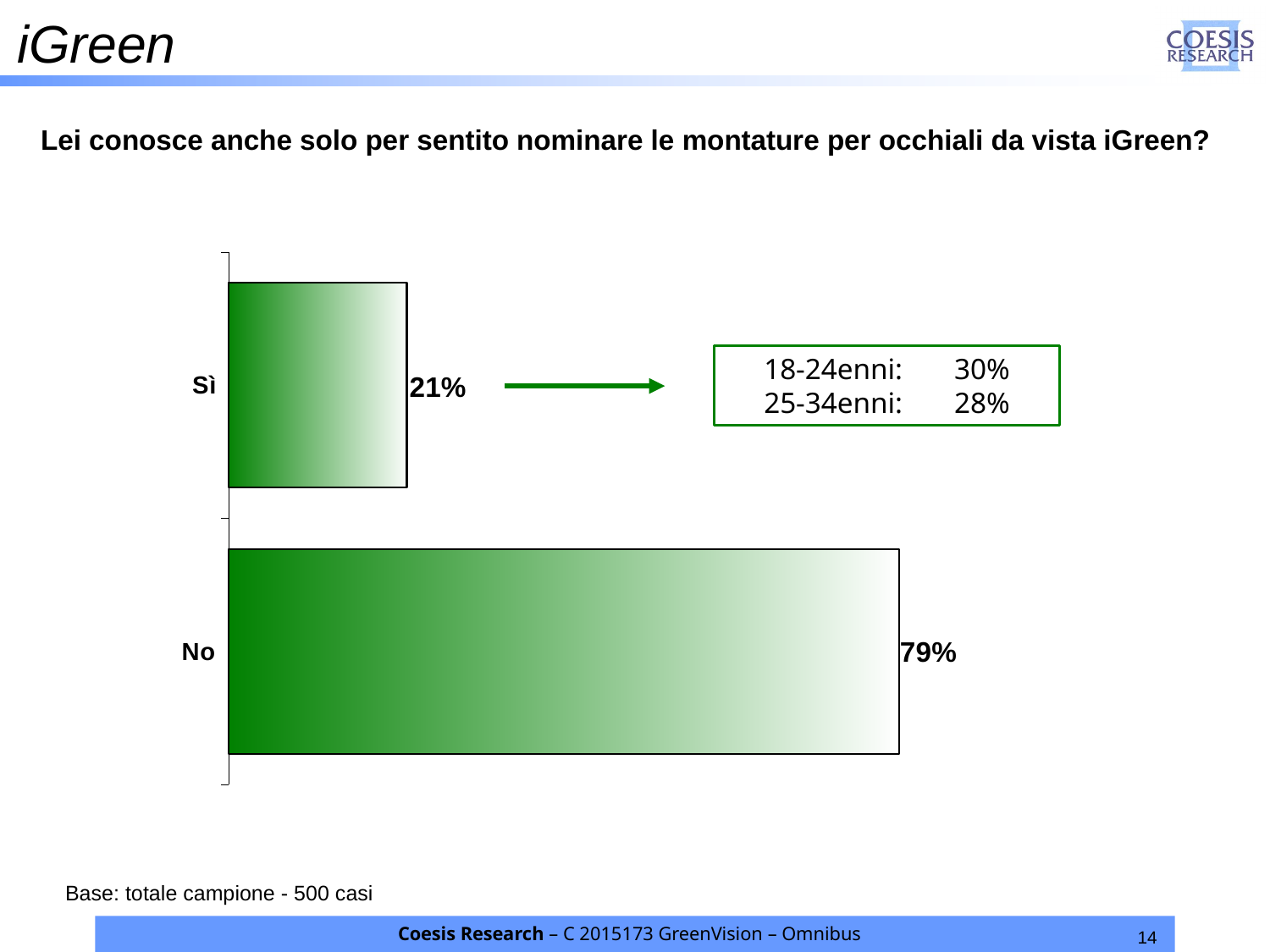
What is the value for "No"? 79% What is the difference between the values for "No" and "Sì"? 58% Which category has the highest value? No What kind of chart is shown on the slide? Bar chart According to the callout box, what is the value for 18-24enni? 30% What is the total of the values for "Sì" and "No"? 100% What is the base (sample size) stated below the chart? 500 casi Which is larger, the value for "Sì" or the value for "No"? No How many categories are shown in the chart? 2 Which category has the lowest value? Sì According to the callout box, what is the value for 25-34enni? 28% What is the value for "Sì"? 21%